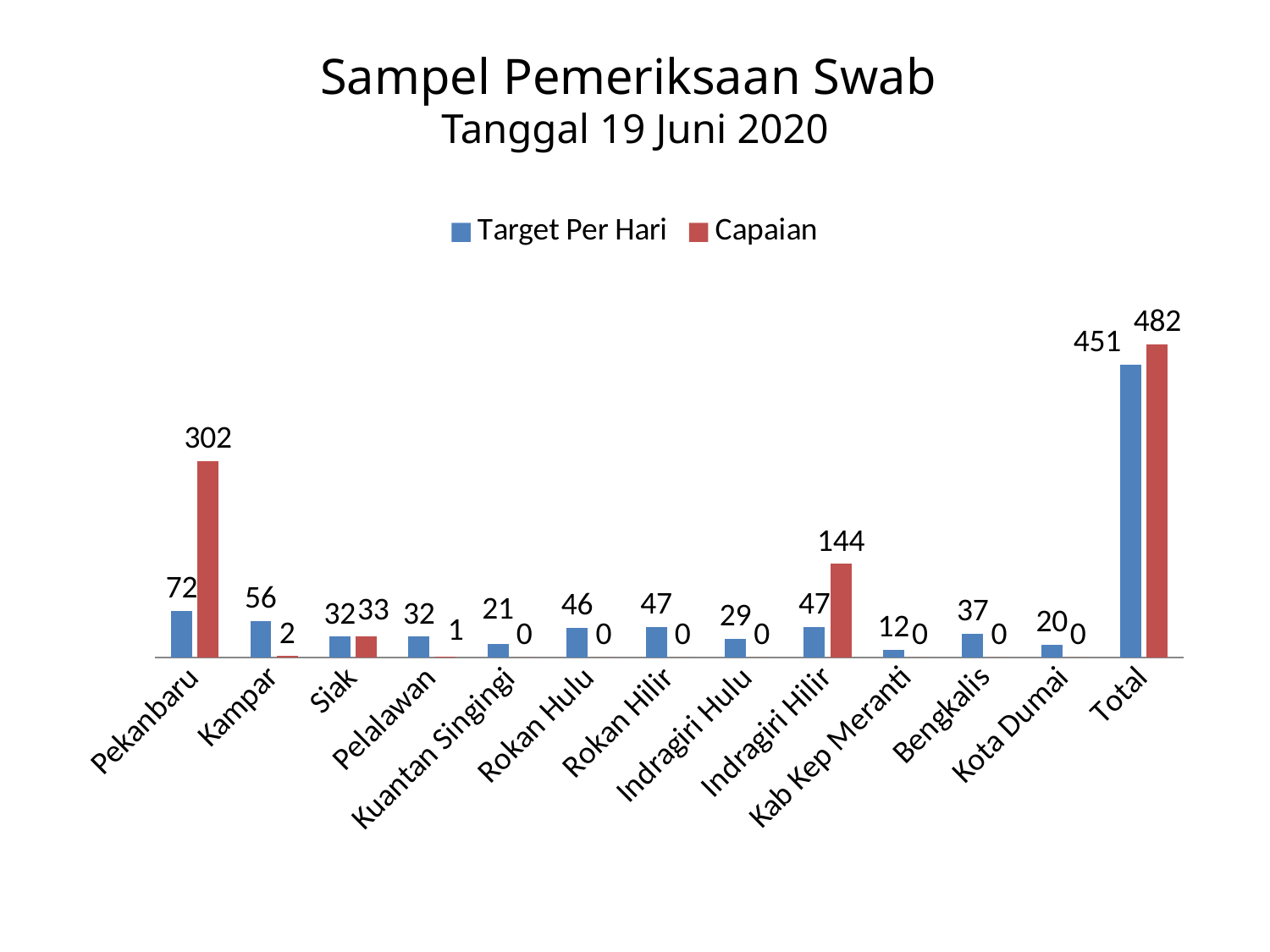
Which is larger for Kampar, Target Per Hari or Capaian? Target Per Hari What is the difference between the Capaian and Target Per Hari values for Total? 31 What is the Capaian value for Pekanbaru? 302 Excluding Total, which category has the lowest Target Per Hari value? Kab Kep Meranti How many categories are shown on the x axis? 13 Excluding Total, which category has the highest Target Per Hari value? Pekanbaru How many series does the legend list? 2 Which is larger for Siak, Target Per Hari or Capaian? Capaian What is the Target Per Hari value for Indragiri Hilir? 47 What is the difference between the Capaian and Target Per Hari values for Pekanbaru? 230 What is the Capaian value for Kampar? 2 What kind of chart is shown on the slide? Bar chart